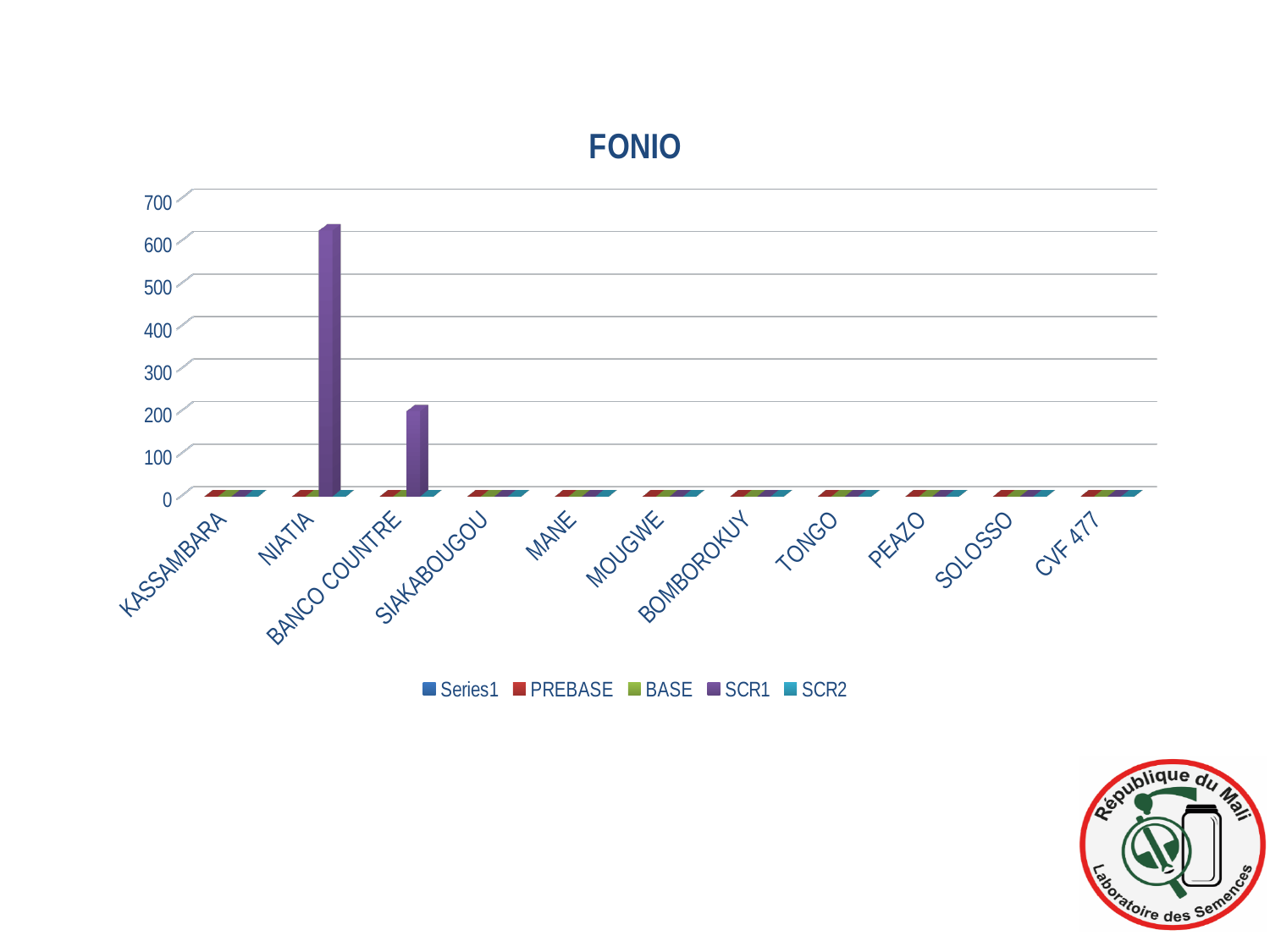
Is the SCR1 value for NIATIA greater or less than 500? greater How many categories are shown on the x axis of the chart? 11 What is the title of the chart? FONIO Which series has the visibly non-zero bars in the chart? SCR1 Is the SCR1 value for NIATIA greater or less than 700? less Which category has the highest SCR1 value? NIATIA What is the highest value shown on the vertical axis? 700 What kind of chart is shown on the slide? bar chart Is the SCR1 value for BANCO COUNTRE greater or less than 100? greater How many series does the legend list? 5 Which is larger, the SCR1 value for NIATIA or the SCR1 value for BANCO COUNTRE? NIATIA